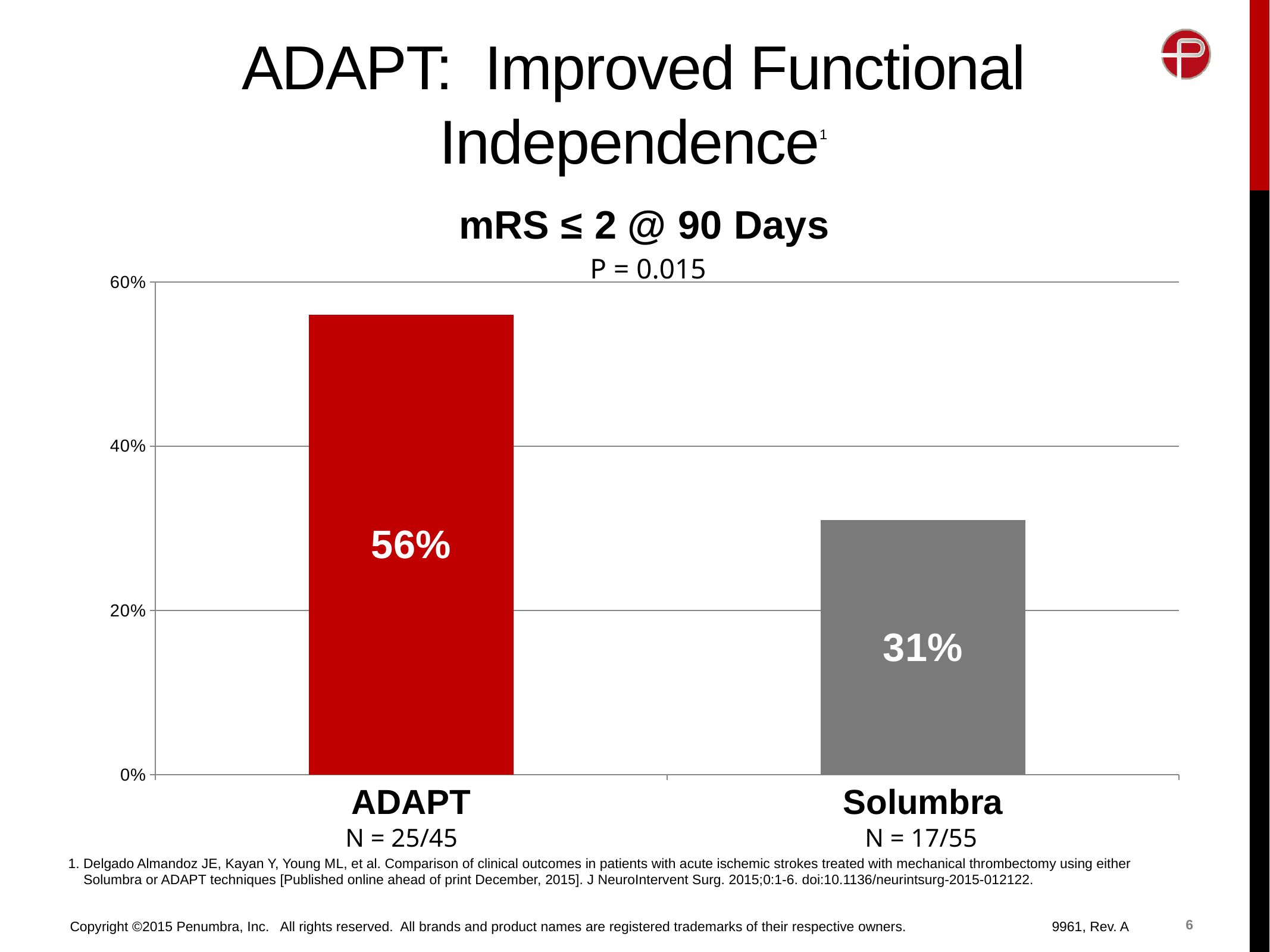
What is the value for ADAPT? 56% Which is larger, the value for ADAPT or the value for Solumbra? ADAPT What kind of chart is shown on the slide? bar chart What P value is shown on the chart? P = 0.015 Which category has the highest value? ADAPT Which category has the lowest value? Solumbra How many categories are shown in the chart? 2 What is the title of the chart? mRS ≤ 2 @ 90 Days Is the value for Solumbra greater or less than 40%? less Is the value for ADAPT greater or less than 40%? greater What is the value for Solumbra? 31% What is the difference between the ADAPT and Solumbra values? 25%